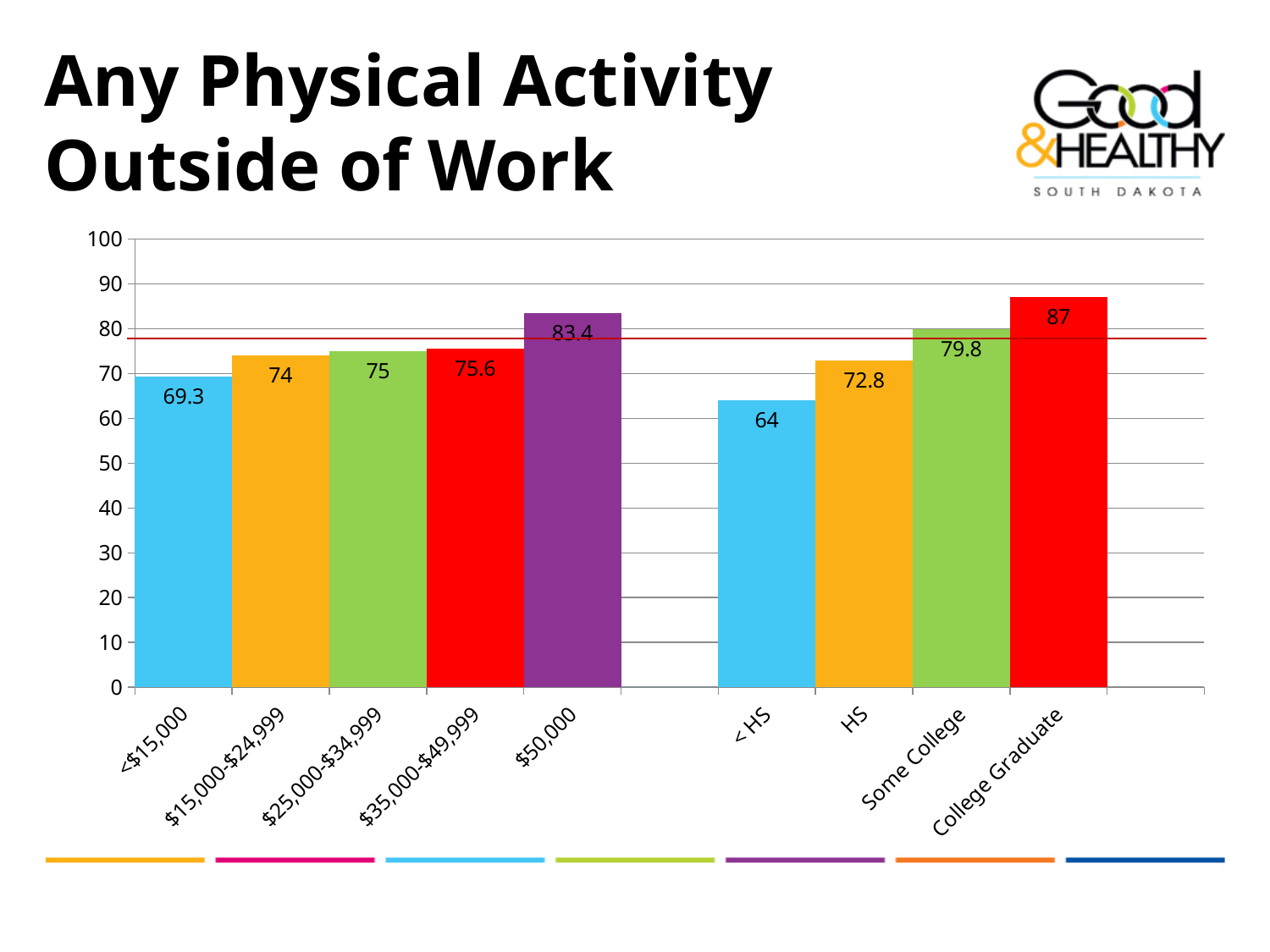
What is the difference between the values for $50,000 and <$15,000? 14.1 What is the difference between the values for College Graduate and < HS? 23 What kind of chart is shown on the slide? Bar chart How many categories are shown on the x axis? 9 What is the value for College Graduate? 87 Which is larger, the value for HS or the value for $15,000-$24,999? $15,000-$24,999 What is the value for the $50,000 category? 83.4 What is the value for the <$15,000 category? 69.3 Which category has the highest value? College Graduate Which category has the lowest value? < HS What is the value for Some College? 79.8 Do the values rise or fall across the income categories from <$15,000 to $50,000? Rise